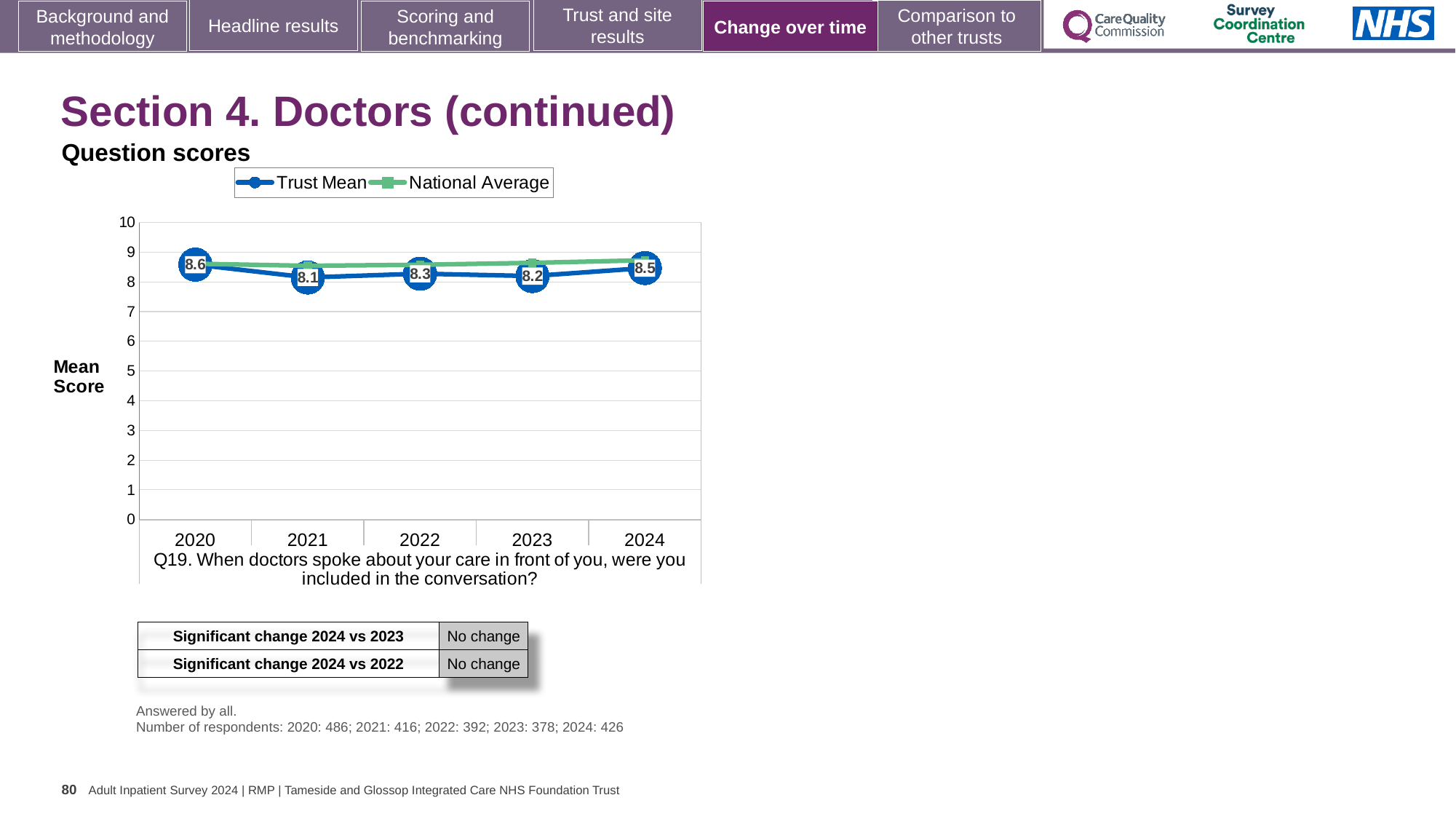
What is the Trust Mean score for 2024? 8.5 In which year is the Trust Mean lowest? 2021 What is the Trust Mean score for 2021? 8.1 Does the Trust Mean rise or fall from 2020 to 2021? Fall What is the Trust Mean score for 2020? 8.6 How many series does the legend list? 2 What is the difference between the Trust Mean in 2020 and in 2021? 0.5 How many years are shown on the x axis? 5 Which is larger, the Trust Mean in 2022 or in 2023? 2022 Is the National Average value for 2024 greater or less than 8? greater What kind of chart is shown? Line chart In which year is the Trust Mean highest? 2020